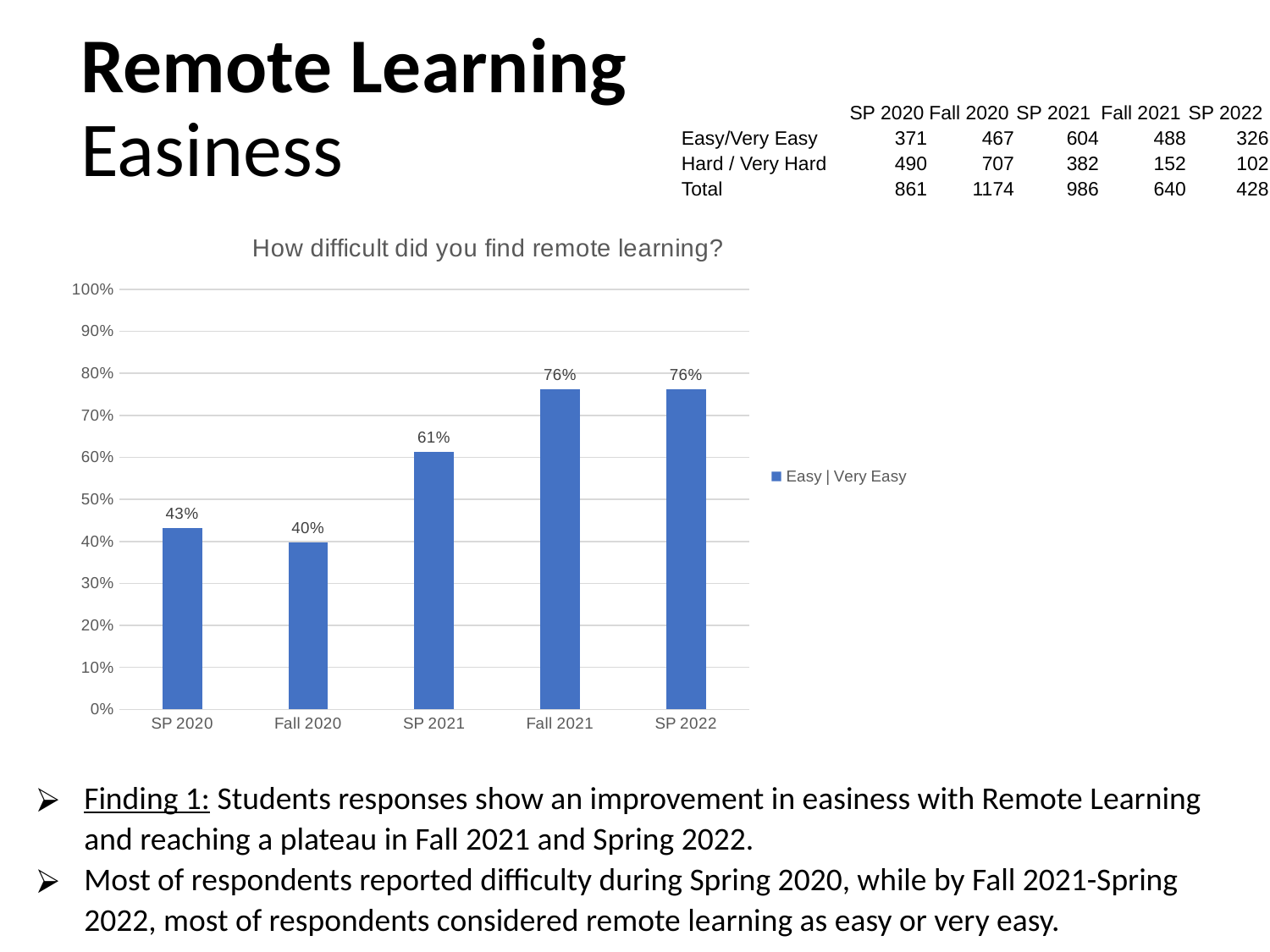
Is the value for Fall 2021 greater or less than 70%? greater What is the value for SP 2020? 43% What is the title of the chart? How difficult did you find remote learning? Which is larger, the value for SP 2021 or the value for Fall 2020? SP 2021 What is the value for Fall 2020? 40% What is the difference between the values for SP 2021 and SP 2020? 18% Which category has the lowest value? Fall 2020 How many series does the legend list? 1 What is the value for SP 2021? 61% Do the values generally rise or fall from SP 2020 to SP 2022? rise What kind of chart is shown? bar chart How many categories are shown on the x axis? 5